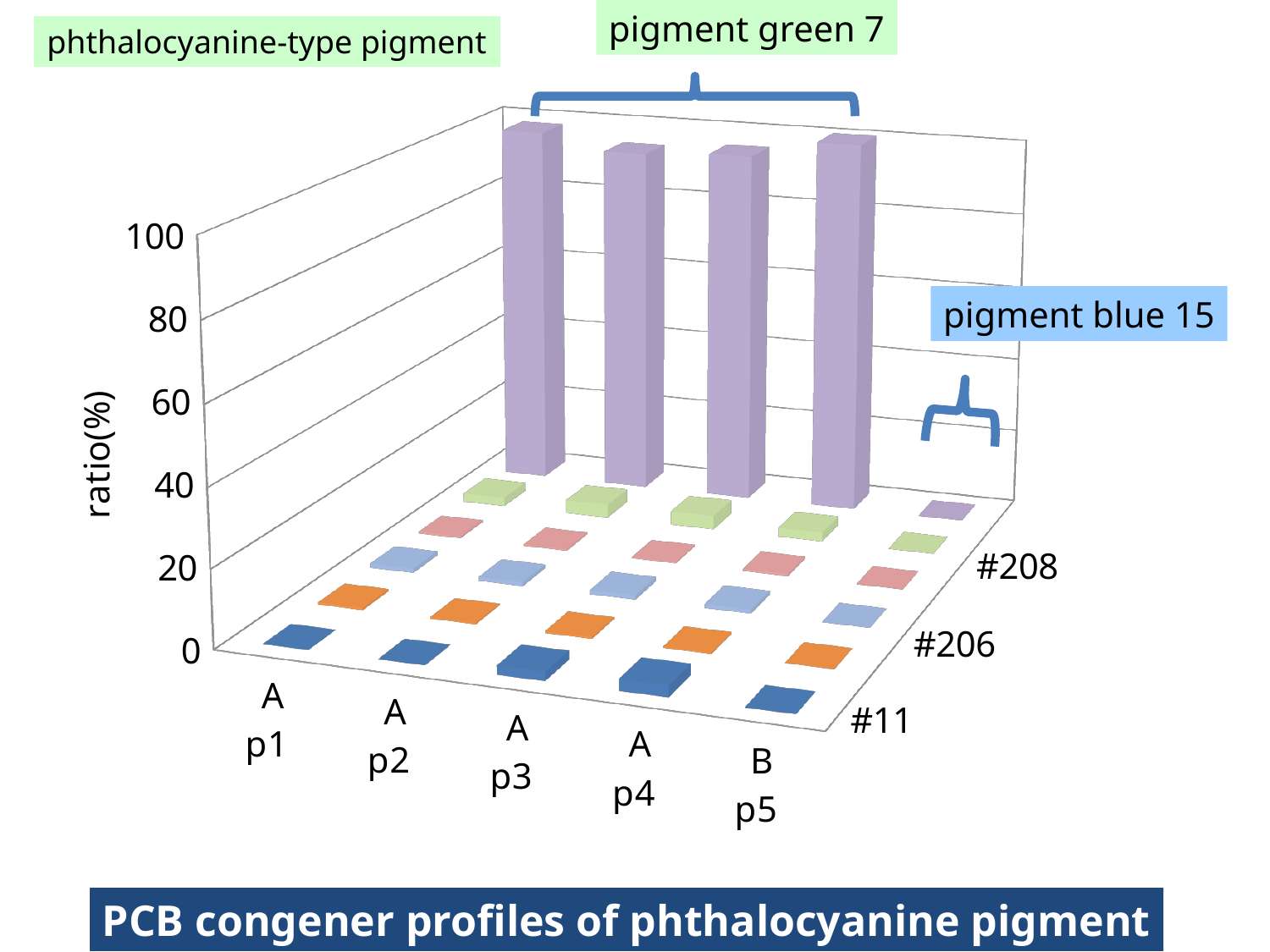
What is the highest tick value shown on the y axis? 100 Is the value of the tallest (purple, back-row) bar for A p1 greater or less than 60? greater What kind of chart is shown on the slide? bar chart What is the title shown beneath the chart? PCB congener profiles of phthalocyanine pigment Which sample has the lowest value in the back-row (purple) series? B p5 Which samples are labelled as pigment green 7 on the chart? A p1, A p2, A p3, A p4 Is the value of the #11 bar for A p1 greater or less than 20? less Is the value of the back-row (purple) bar for B p5 greater or less than 40? less How many sample categories are shown along the x axis of the chart? 5 For A p2, which is larger: the back-row (purple) bar or the #11 bar? the back-row (purple) bar